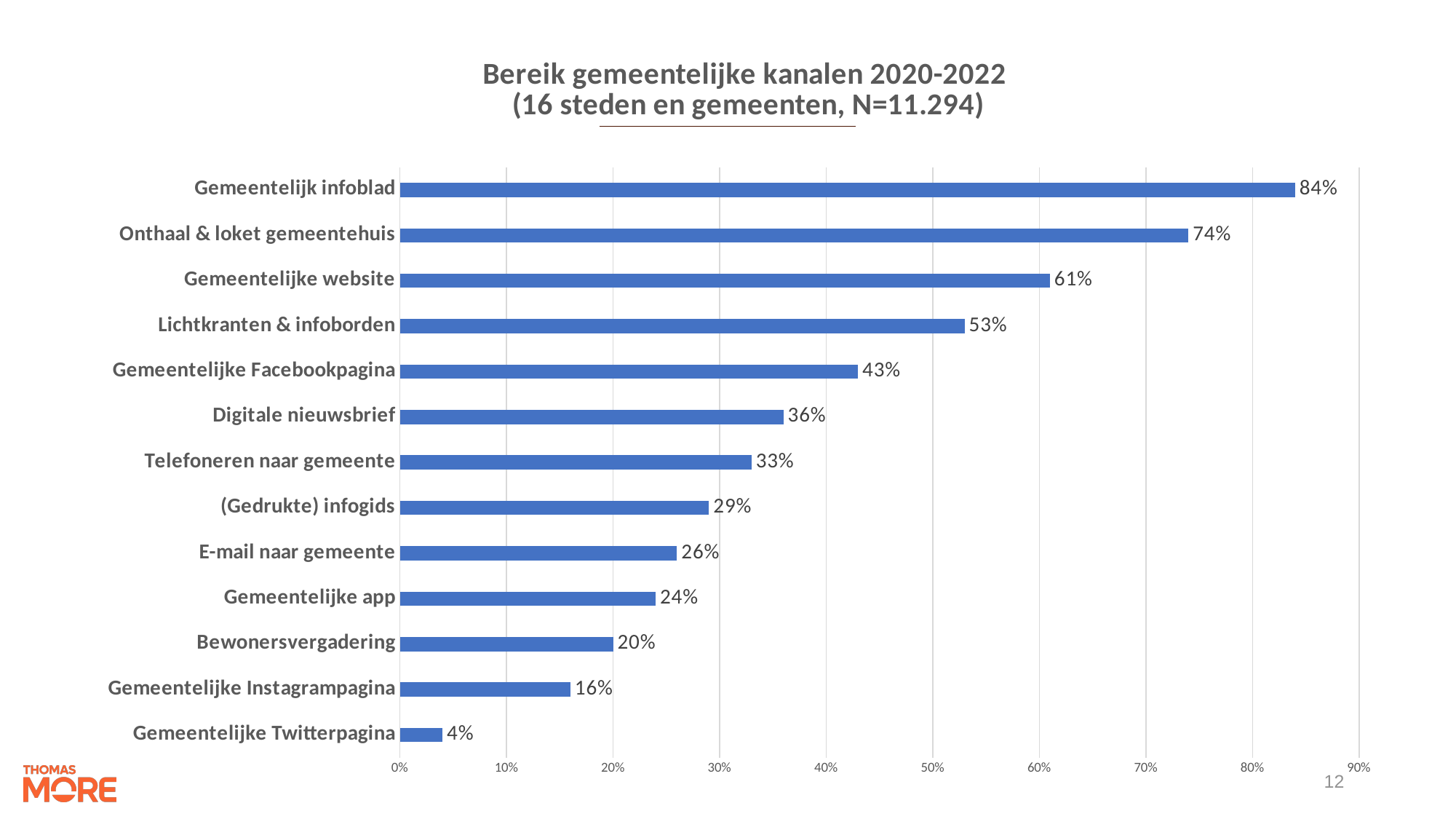
What is the difference between Gemeentelijke Instagrampagina and Gemeentelijke Twitterpagina? 12% What kind of chart is shown on the slide? Bar chart Which category has the highest value? Gemeentelijk infoblad Is the value for Lichtkranten & infoborden greater or less than 50%? greater Which is larger, Digitale nieuwsbrief or Telefoneren naar gemeente? Digitale nieuwsbrief What is the difference between Onthaal & loket gemeentehuis and Gemeentelijke website? 13% Which category has the lowest value? Gemeentelijke Twitterpagina How many categories are shown in the chart? 13 What is the value for Gemeentelijk infoblad? 84% What is the value for Gemeentelijke Facebookpagina? 43% What is the value for Gemeentelijke app? 24% What is the title of the chart? Bereik gemeentelijke kanalen 2020-2022 (16 steden en gemeenten, N=11.294)